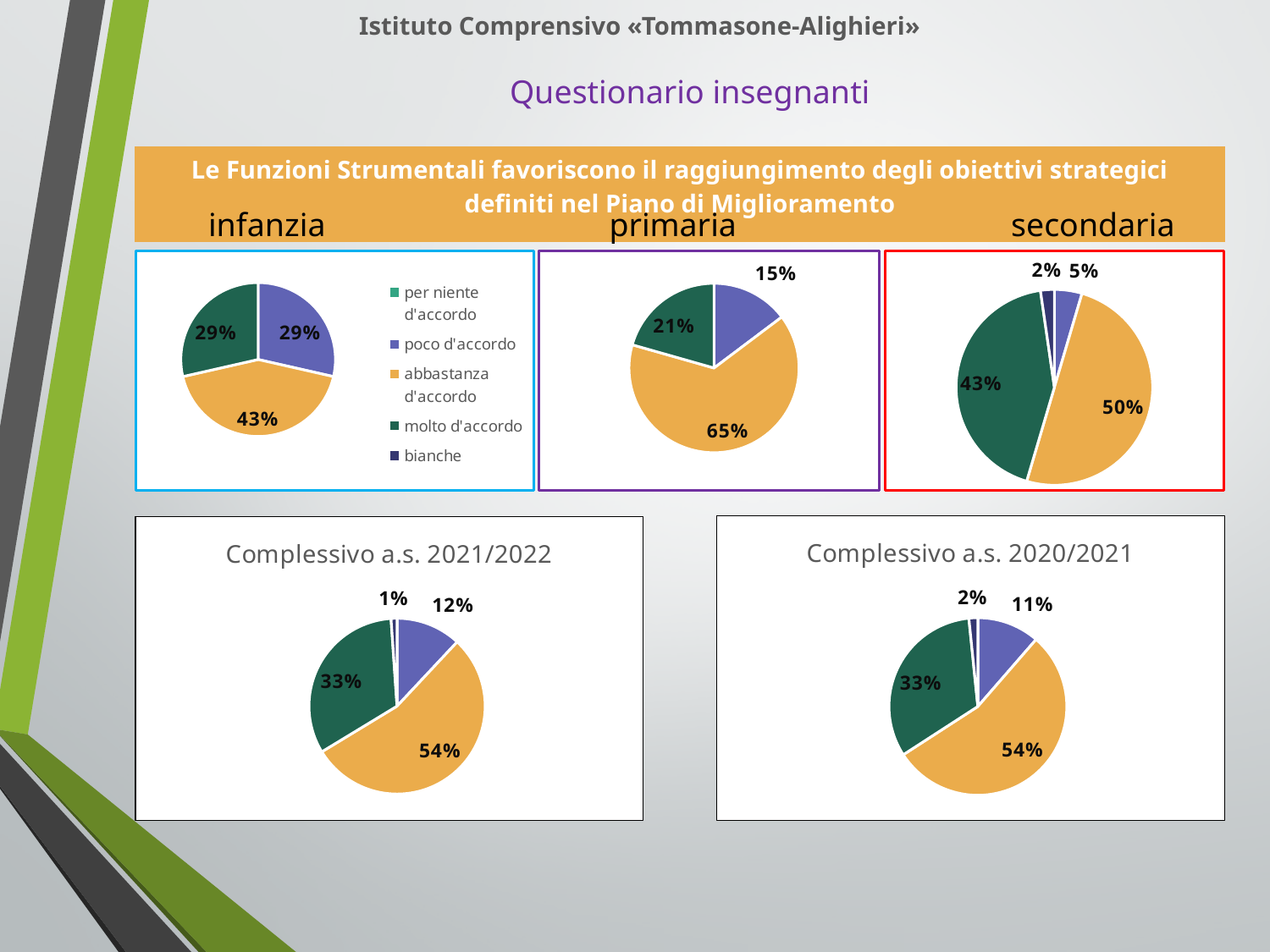
In the 'secondaria' pie chart, what share is 'poco d'accordo'? 5% In the 'secondaria' pie chart, what is the difference between 'abbastanza d'accordo' and 'molto d'accordo'? 7% In the 'secondaria' pie chart, which category has the smallest slice? bianche In the 'Complessivo a.s. 2021/2022' pie chart, which is larger: 'molto d'accordo' or 'poco d'accordo'? molto d'accordo In the 'Complessivo a.s. 2020/2021' pie chart, what share is 'poco d'accordo'? 11% How many slices does the 'infanzia' pie chart have? 3 In the 'primaria' pie chart, what share is 'molto d'accordo'? 21% What type of chart is used for 'Complessivo a.s. 2020/2021'? pie chart In the 'infanzia' pie chart, what share is 'abbastanza d'accordo'? 43% In the 'primaria' pie chart, which category has the largest slice? abbastanza d'accordo In the 'Complessivo a.s. 2021/2022' pie chart, what share is 'bianche'? 1% How many entries does the legend next to the 'infanzia' pie chart list? 5